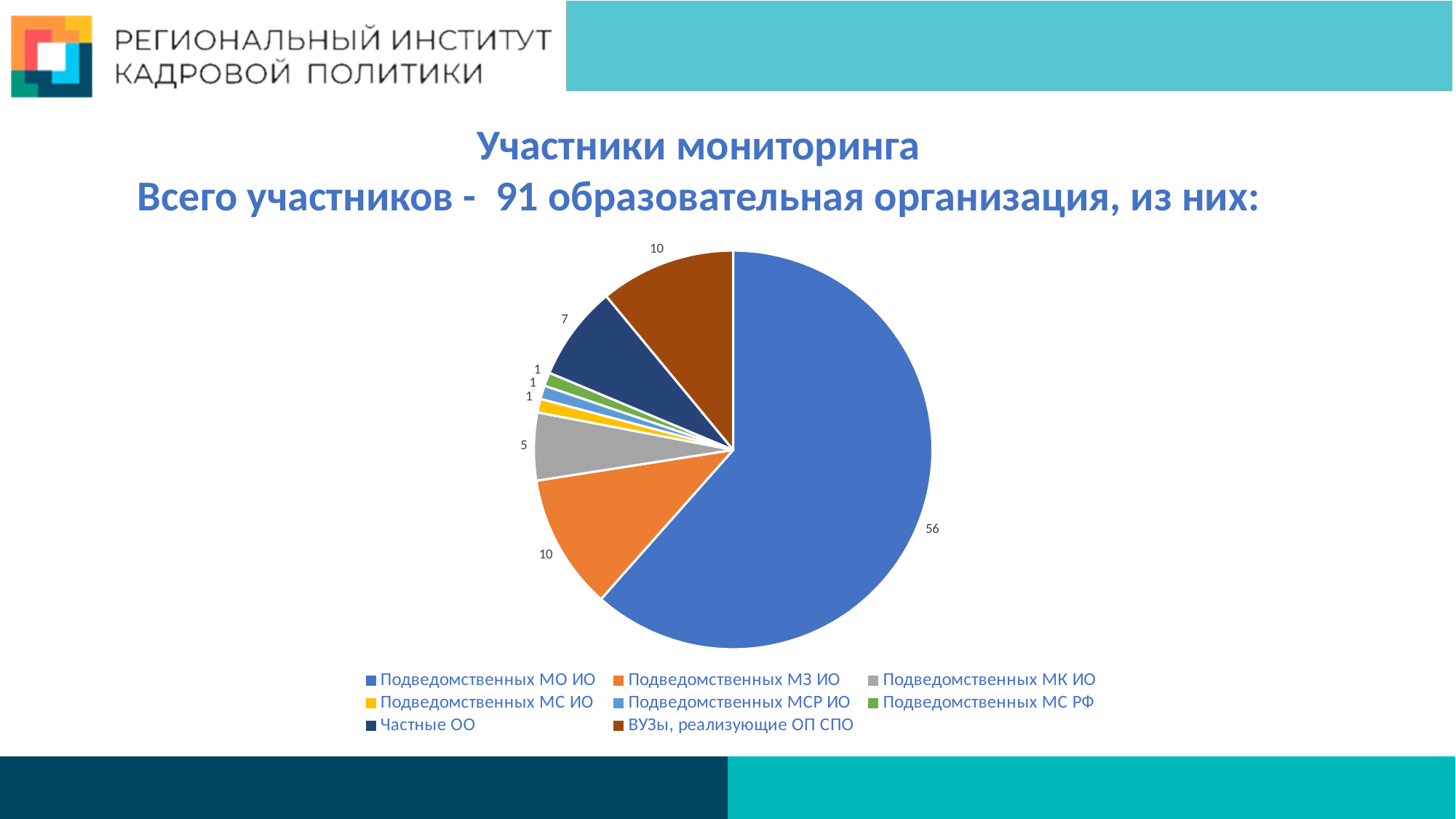
What is the value for ВУЗы, реализующие ОП СПО? 10 What is the value for Частные ОО? 7 What is the value for Подведомственных МО ИО? 56 What is the value for Подведомственных МК ИО? 5 What is the total number of participants stated in the slide title? 91 What is the difference between the values for Подведомственных МО ИО and Подведомственных МЗ ИО? 46 What kind of chart is shown on the slide? pie chart How many slices does the pie chart have? 8 What is the value for Подведомственных МЗ ИО? 10 What is the difference between the values for Частные ОО and Подведомственных МК ИО? 2 Which category has the largest slice of the pie? Подведомственных МО ИО Which is larger, the value for Подведомственных МЗ ИО or Подведомственных МК ИО? Подведомственных МЗ ИО